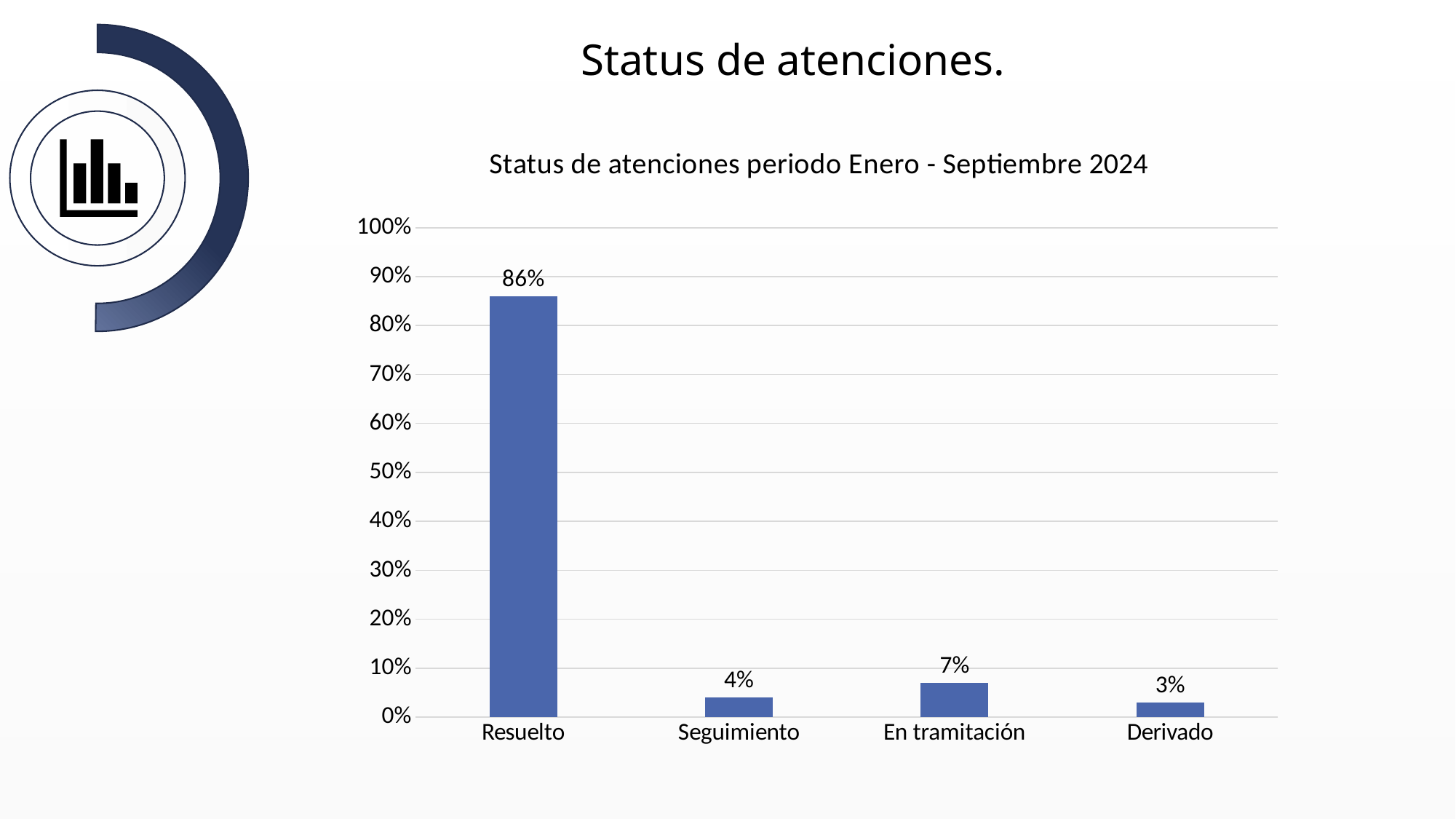
What is the difference between the values for Resuelto and En tramitación? 79% What is the value for Resuelto? 86% What kind of chart is shown on the slide? Bar chart Is the value for Resuelto greater or less than 80%? greater How many categories are shown on the x axis? 4 Which category has the lowest value? Derivado What is the value for Derivado? 3% What is the title of the chart? Status de atenciones periodo Enero - Septiembre 2024 Which is larger, the value for Seguimiento or the value for En tramitación? En tramitación Which category has the highest value? Resuelto What is the value for En tramitación? 7% What is the value for Seguimiento? 4%